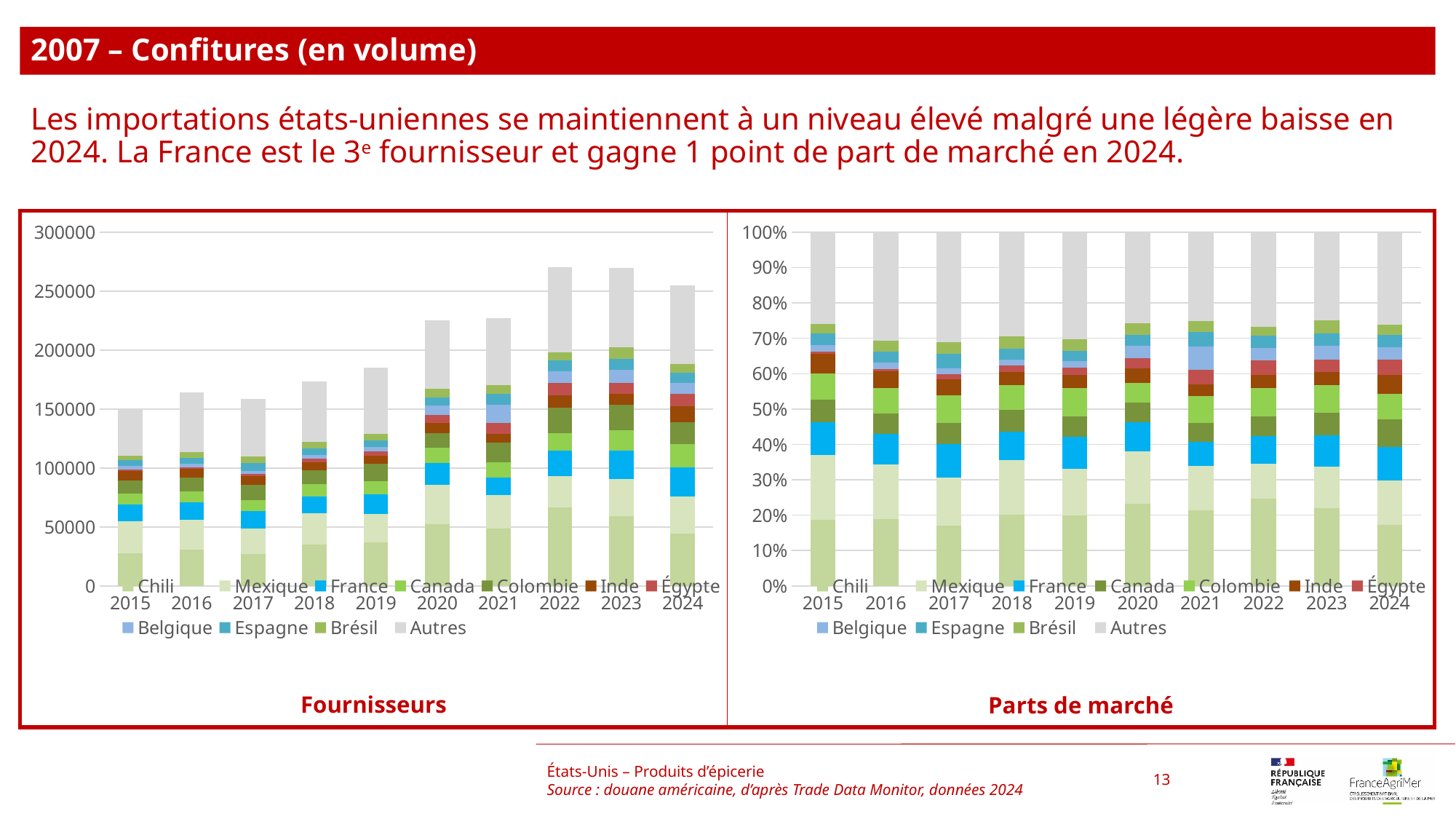
What kind of chart is the 'Fournisseurs' chart on the left? stacked bar chart In the 'Fournisseurs' chart, how many years are shown on the x axis? 10 In the 'Parts de marché' chart, is the share for Chili in 2020 greater or less than 30%? less In the 'Fournisseurs' chart, do the total bars generally rise or fall from 2015 to 2023? rise In the 'Parts de marché' chart, how many series does the legend list? 11 In the 'Fournisseurs' chart, is the total bar for 2015 greater or less than 200000? less In the 'Fournisseurs' chart, is the total bar for 2020 greater or less than 200000? greater In the 'Fournisseurs' chart, which year has the lowest total bar? 2015 In the 'Fournisseurs' chart, which total bar is larger, 2015 or 2024? 2024 What is the title of the chart on the right? Parts de marché What kind of chart is the 'Parts de marché' chart on the right? 100% stacked bar chart